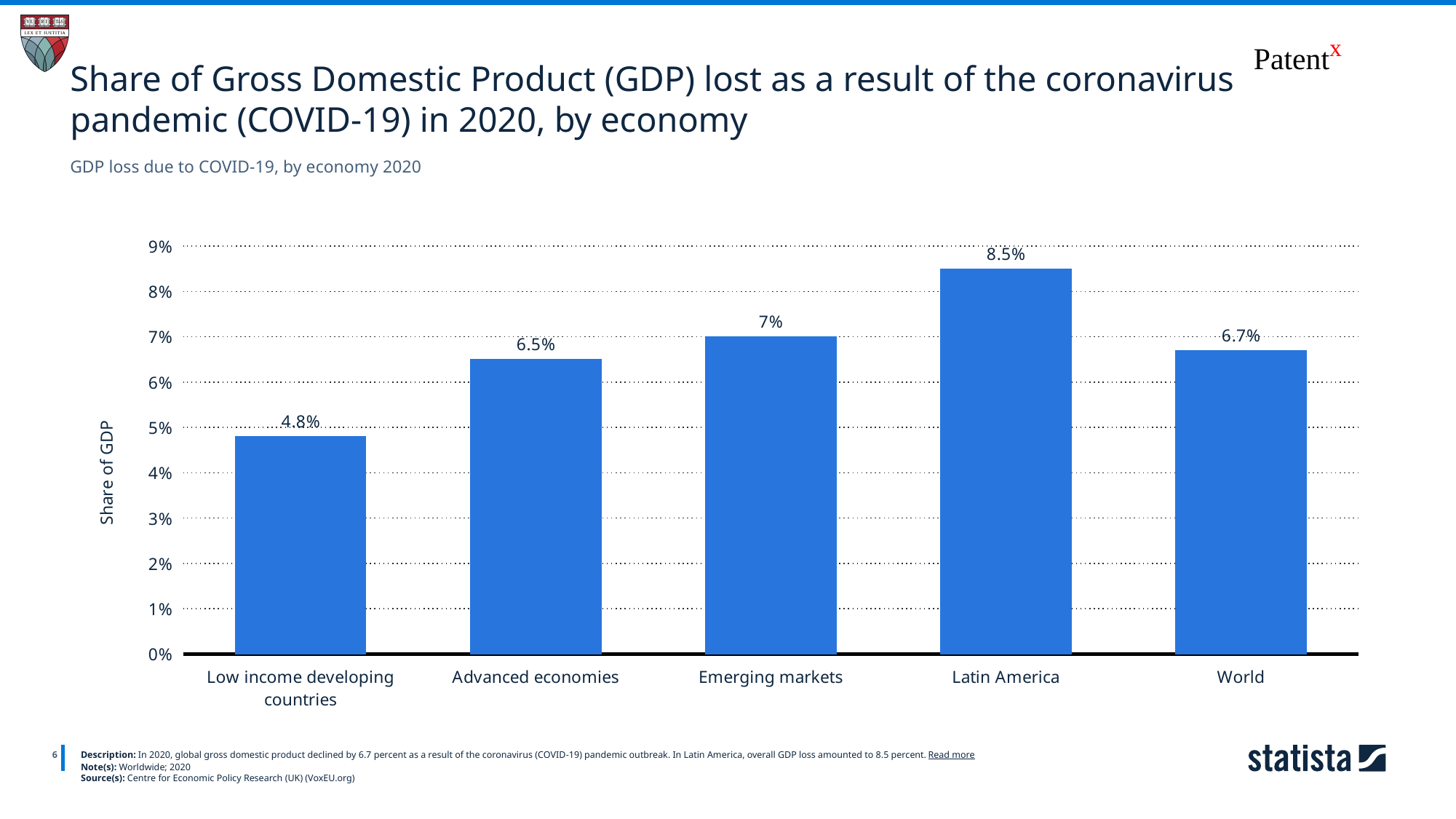
What is the difference between the values for Latin America and Advanced economies? 2% Which economy has the highest share of GDP lost? Latin America What share of GDP was lost in Low income developing countries? 4.8% What share of GDP was lost in Latin America? 8.5% Which economy has the lowest share of GDP lost? Low income developing countries What share of GDP was lost in Emerging markets? 7% What is the value for World? 6.7% Is the value for Advanced economies greater or less than 6%? greater What is the label of the vertical axis? Share of GDP How many economies are shown on the chart? 5 Which is larger, the value for Emerging markets or the value for World? Emerging markets What kind of chart is shown on the slide? Bar chart